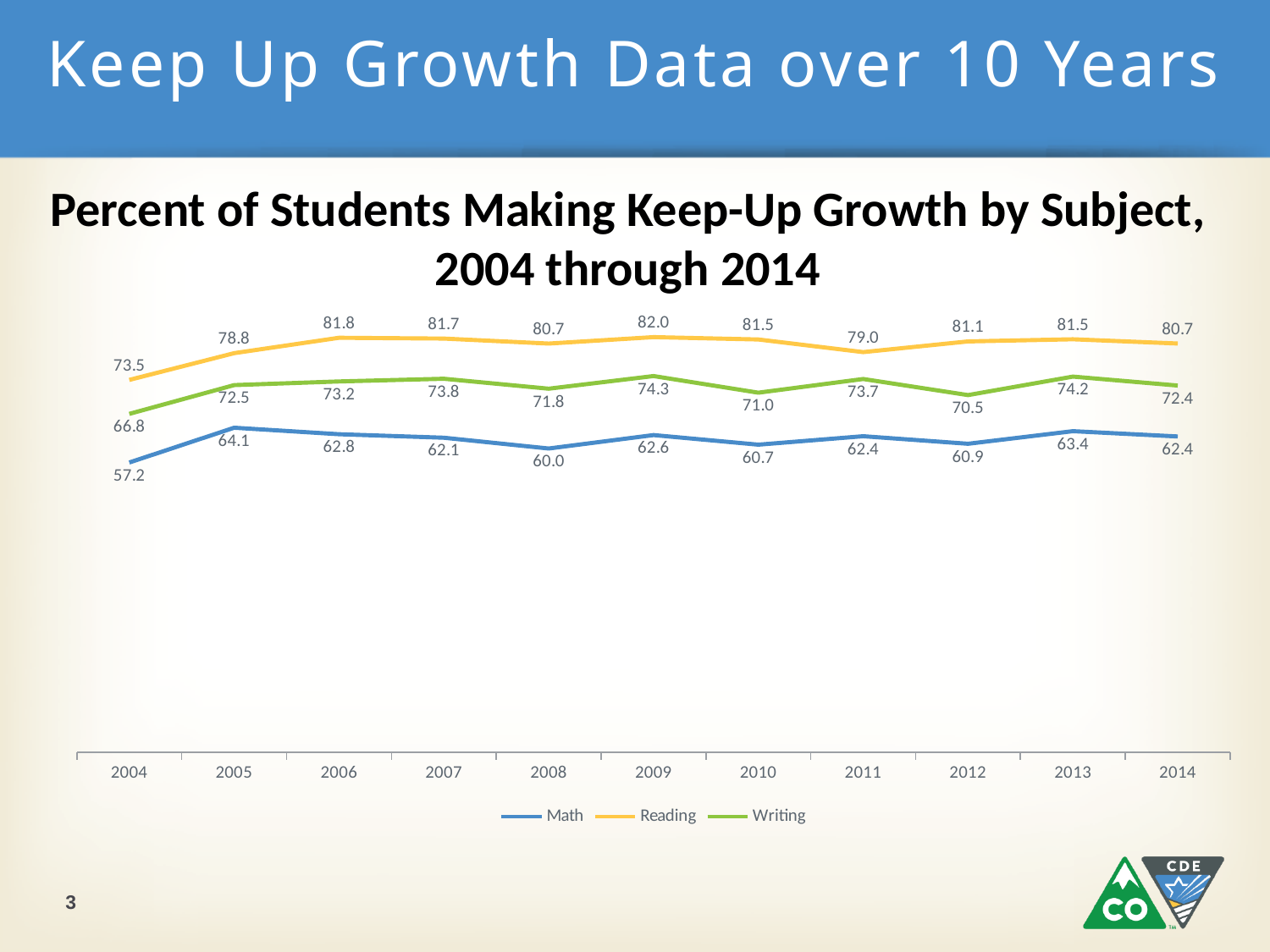
In which year is the Reading value highest? 2009 In which year is the Math value lowest? 2004 What is the Reading value for 2009? 82.0 What is the Math value for 2004? 57.2 What type of chart is shown on the slide? line chart What is the Writing value for 2012? 70.5 Which is larger in 2011, the Writing value or the Math value? Writing What is the difference between the Reading and Math values in 2014? 18.3 How many series does the legend list? 3 Does the Math value rise or fall from 2004 to 2005? rise How many years are shown on the x axis? 11 Which series is shown with the yellow line? Reading